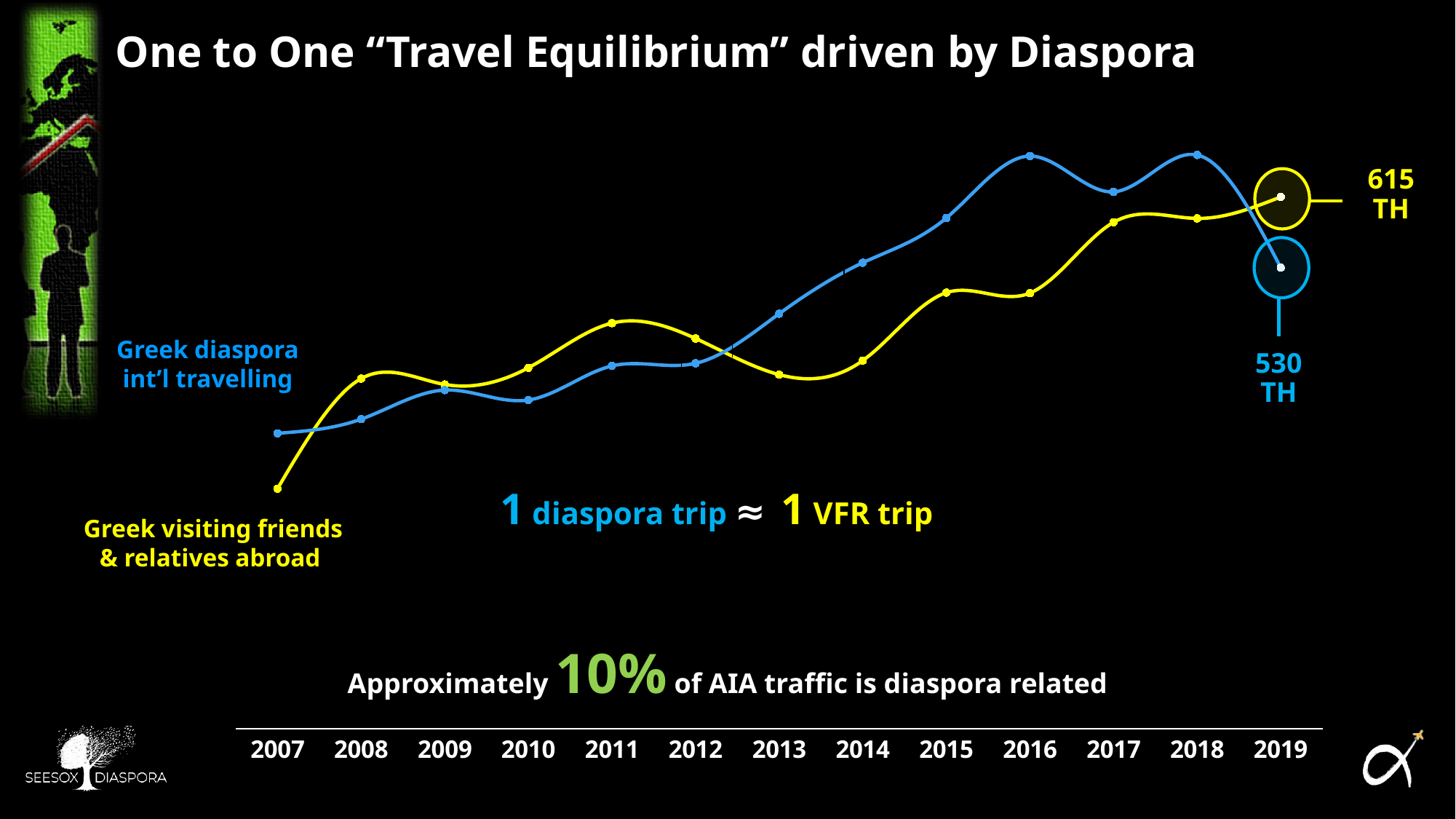
How many series are plotted on the chart? 2 In which year is the Greek diaspora int'l travelling series at its lowest? 2007 In which year is the Greek visiting friends & relatives abroad series at its lowest? 2007 In which year is the Greek visiting friends & relatives abroad series at its highest? 2019 What is the value of the Greek diaspora int'l travelling series in 2019? 530 TH In 2019, which series has the higher value: Greek diaspora int'l travelling or Greek visiting friends & relatives abroad? Greek visiting friends & relatives abroad How many years are shown on the x axis of the chart? 13 In 2016, which series has the higher value: Greek diaspora int'l travelling or Greek visiting friends & relatives abroad? Greek diaspora int'l travelling What is the difference between the two series' values in 2019? 85 TH In 2007, which series has the higher value: Greek diaspora int'l travelling or Greek visiting friends & relatives abroad? Greek diaspora int'l travelling What kind of chart is shown on the slide? Line chart What is the value of the Greek visiting friends & relatives abroad series in 2019? 615 TH